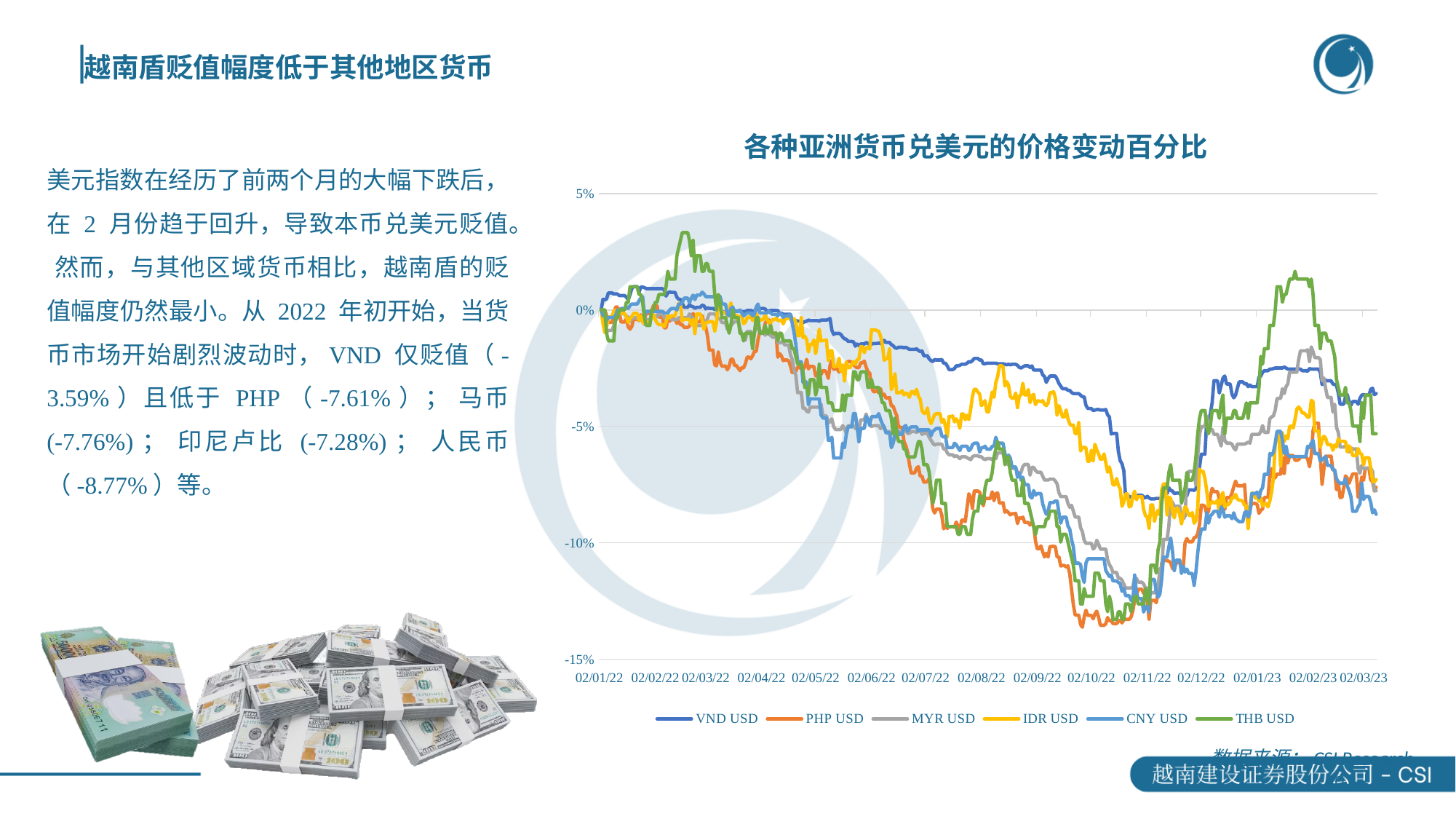
How many date labels are shown along the x axis of the chart? 15 What is the title of the chart? 各种亚洲货币兑美元的价格变动百分比 Is the peak value of THB USD around 02/02/22 greater or less than 0%? greater How many series does the legend of the chart list? 6 At the right end of the chart (02/03/23), which is higher: VND USD or CNY USD? VND USD Which series in the chart is drawn in green? THB USD Around 02/11/22, is the value of VND USD greater or less than -5%? less What kind of chart is shown on the slide? line chart Is the value of PHP USD around 02/10/22 greater or less than -10%? less Which series has the highest value at the right end of the chart (02/03/23)? VND USD Does the VND USD line overall rise or fall from 02/01/22 to 02/03/23? fall